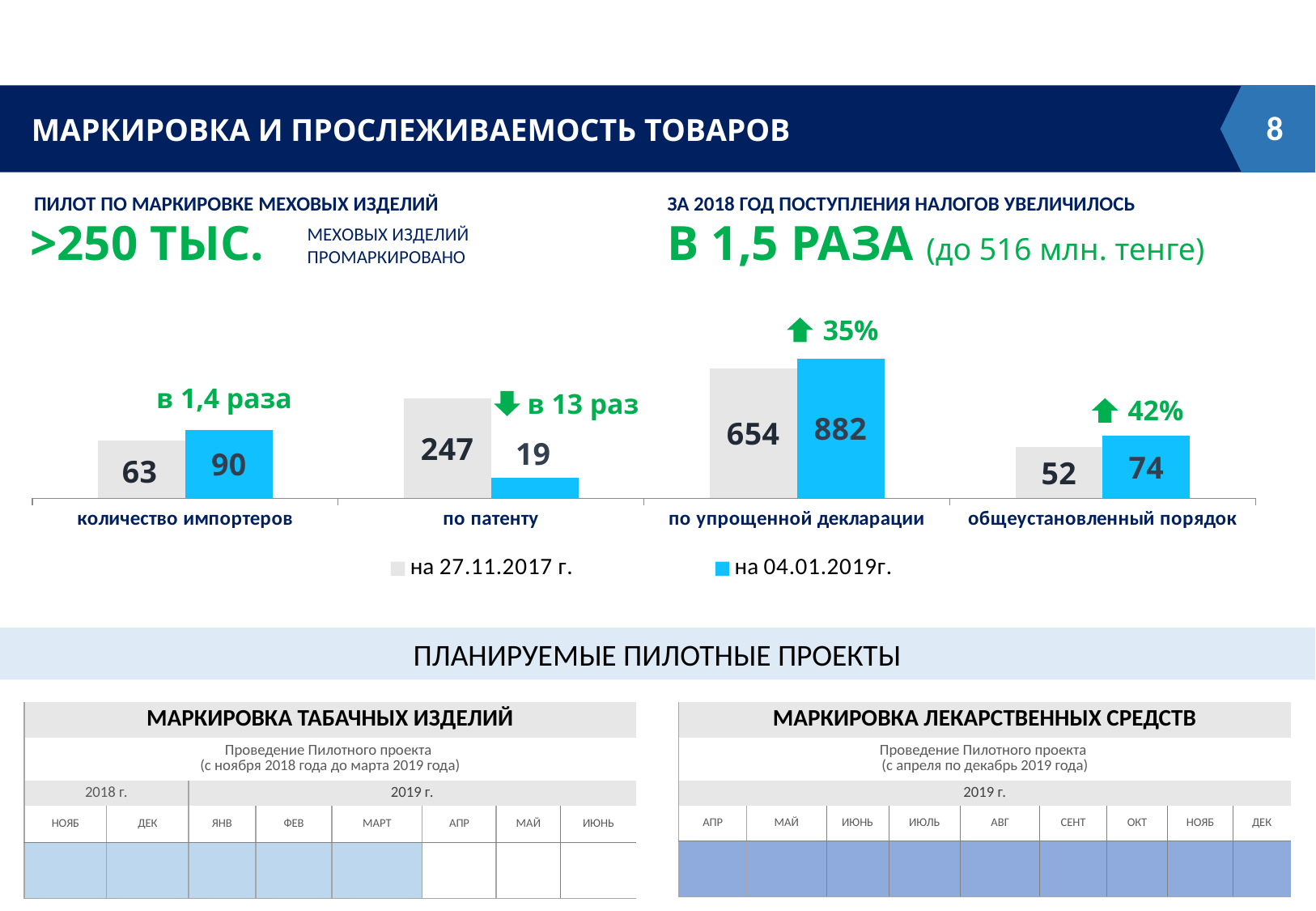
How many categories are shown on the x axis of the bar chart? 4 What is the value for 'по патенту' in the 'на 27.11.2017 г.' series? 247 What is the value for 'общеустановленный порядок' in the 'на 27.11.2017 г.' series? 52 What is the difference between the 'на 27.11.2017 г.' and 'на 04.01.2019г.' values for 'по патенту'? 228 What is the value for 'количество импортеров' in the 'на 04.01.2019г.' series? 90 Which category has the lowest value in the 'на 04.01.2019г.' series? по патенту For 'общеустановленный порядок', which series has the larger value: 'на 27.11.2017 г.' or 'на 04.01.2019г.'? на 04.01.2019г. What is the value for 'по упрощенной декларации' in the 'на 04.01.2019г.' series? 882 Which category has the highest value in the 'на 04.01.2019г.' series? по упрощенной декларации What kind of chart is shown in the middle of the slide? bar chart What is the difference between the 'на 04.01.2019г.' and 'на 27.11.2017 г.' values for 'по упрощенной декларации'? 228 How many series does the legend of the bar chart list? 2